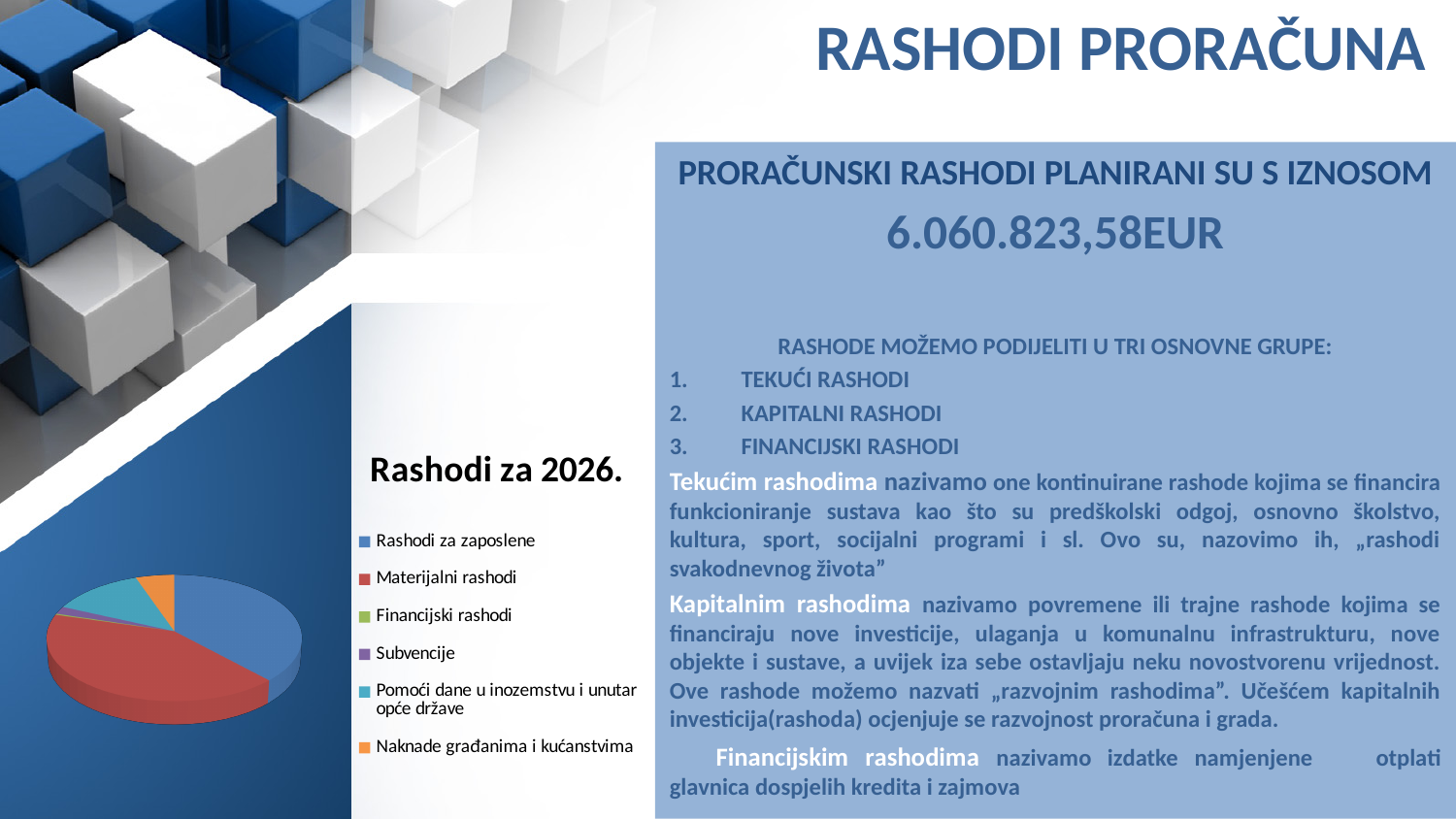
Which is larger in the pie chart, the slice for Materijalni rashodi or the slice for Pomoći dane u inozemstvu i unutar opće države? Materijalni rashodi Which is larger in the pie chart, the slice for Materijalni rashodi or the slice for Financijski rashodi? Materijalni rashodi Which is larger in the pie chart, the slice for Pomoći dane u inozemstvu i unutar opće države or the slice for Subvencije? Pomoći dane u inozemstvu i unutar opće države What kind of chart is shown on the slide? pie chart Which colour represents Materijalni rashodi in the pie chart? red What is the title of the chart on the slide? Rashodi za 2026. How many categories does the legend of the pie chart list? 6